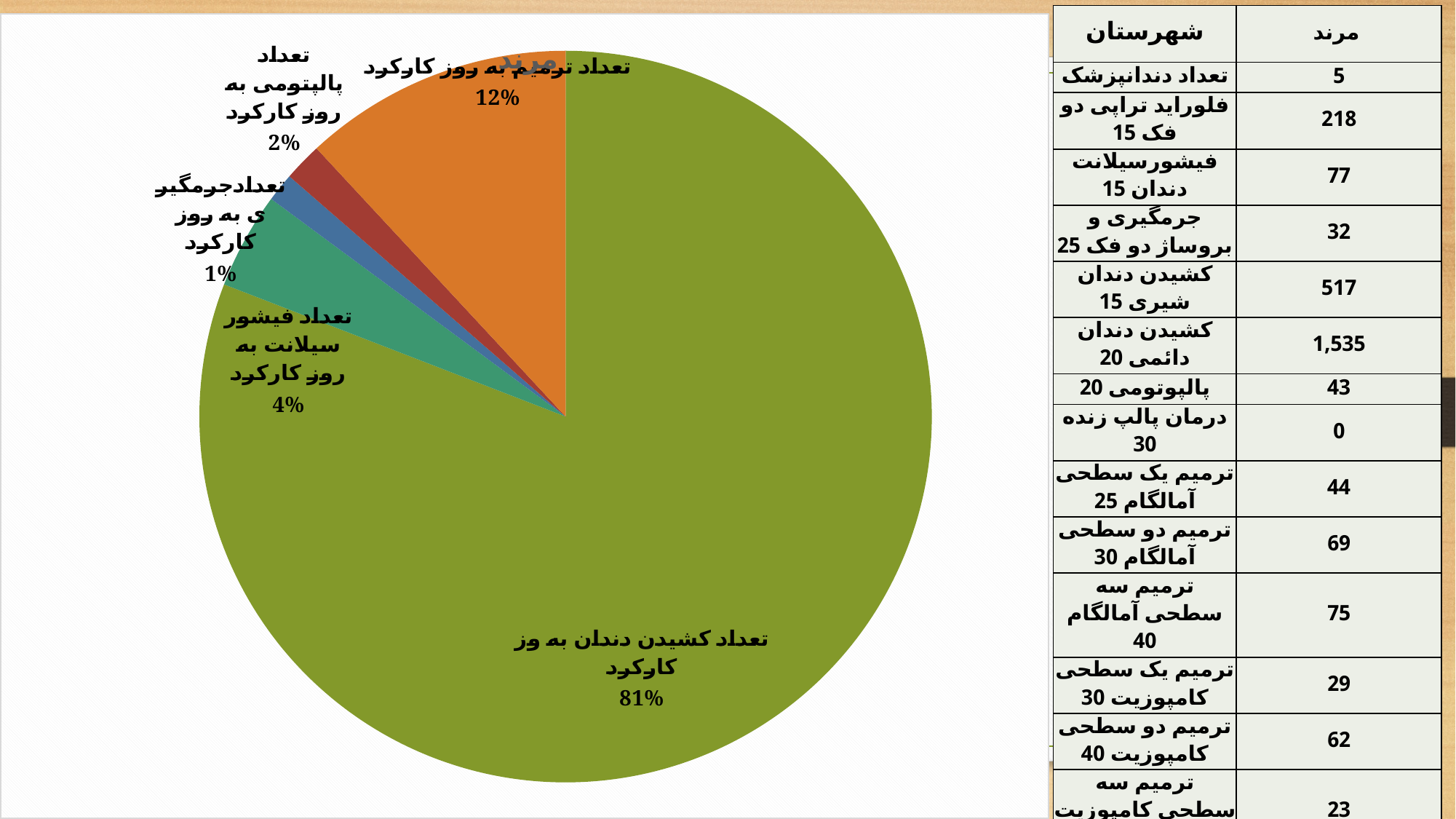
Which slice of the pie chart is the largest? تعداد کشیدن دندان به روز کارکرد What kind of chart is shown on the slide? pie chart Which slice is larger, تعداد فیشور سیلانت به روز کارکرد or تعداد پالپوتومی به روز کارکرد? تعداد فیشور سیلانت به روز کارکرد What share of the pie does تعداد فیشور سیلانت به روز کارکرد have? 4% What is the title of the pie chart? مرند What share of the pie does تعداد ترمیم به روز کارکرد have? 12% What share of the pie does تعداد کشیدن دندان به روز کارکرد have? 81% How many slices does the pie chart have? 5 What is the difference in percentage points between the تعداد کشیدن دندان به روز کارکرد slice and the تعداد ترمیم به روز کارکرد slice? 69 Which slice of the pie chart is the smallest? تعداد جرمگیری به روز کارکرد